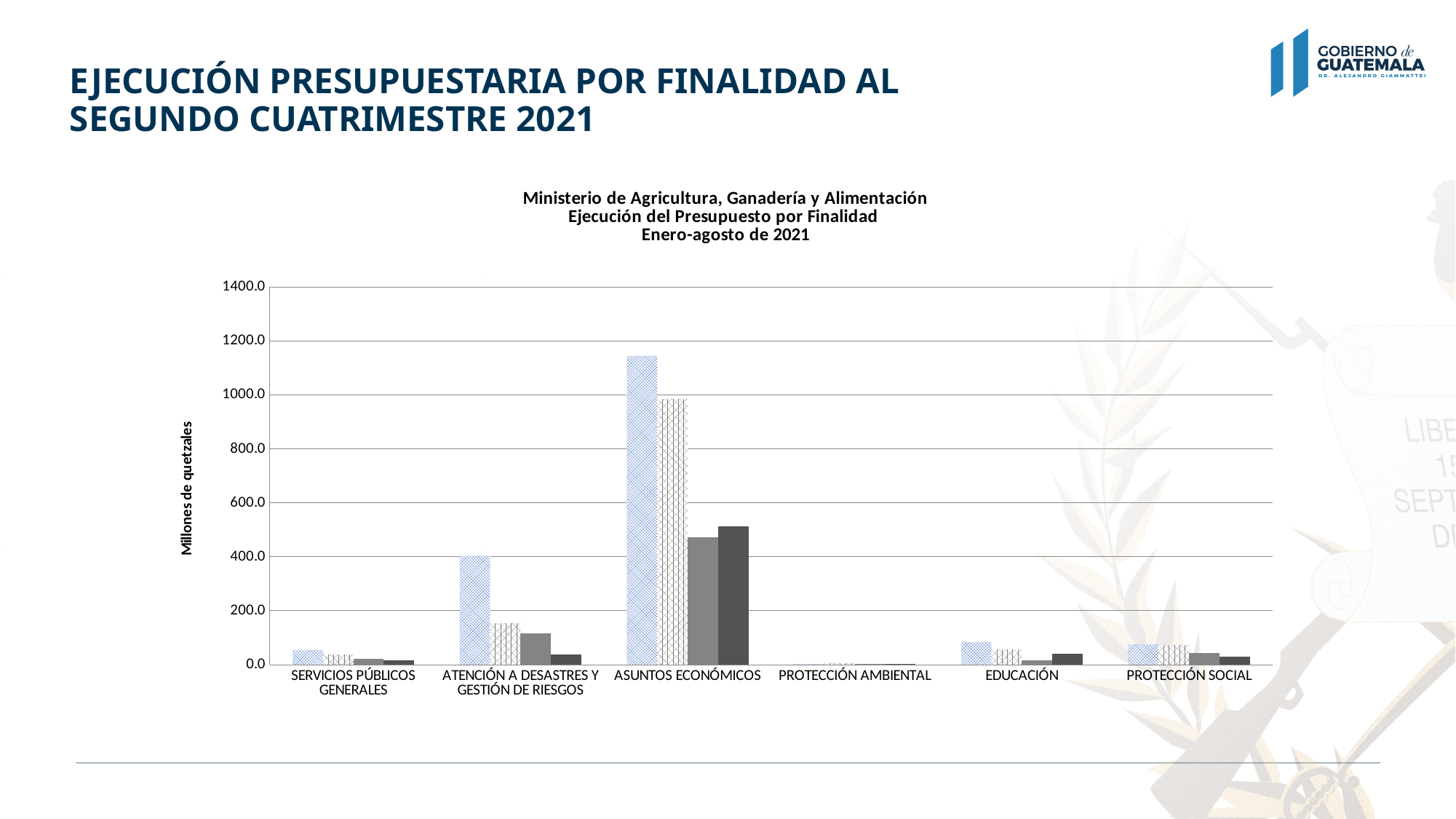
How many categories are shown on the x axis of the chart? 6 Which category has a larger first (light blue) bar: ASUNTOS ECONÓMICOS or ATENCIÓN A DESASTRES Y GESTIÓN DE RIESGOS? ASUNTOS ECONÓMICOS What kind of chart is shown on the slide? bar chart What period does the chart title say the data covers? Enero-agosto de 2021 Which category has the tallest bars in the chart? ASUNTOS ECONÓMICOS What is the label of the y axis of the chart? Millones de quetzales Is the value of the fourth (dark grey) bar for ASUNTOS ECONÓMICOS greater or less than 400? greater Which category has the lowest bars in the chart? PROTECCIÓN AMBIENTAL Is the value of the first (light blue) bar for ASUNTOS ECONÓMICOS greater or less than 1000? greater Is the value of the third (grey) bar for ASUNTOS ECONÓMICOS greater or less than 600? less